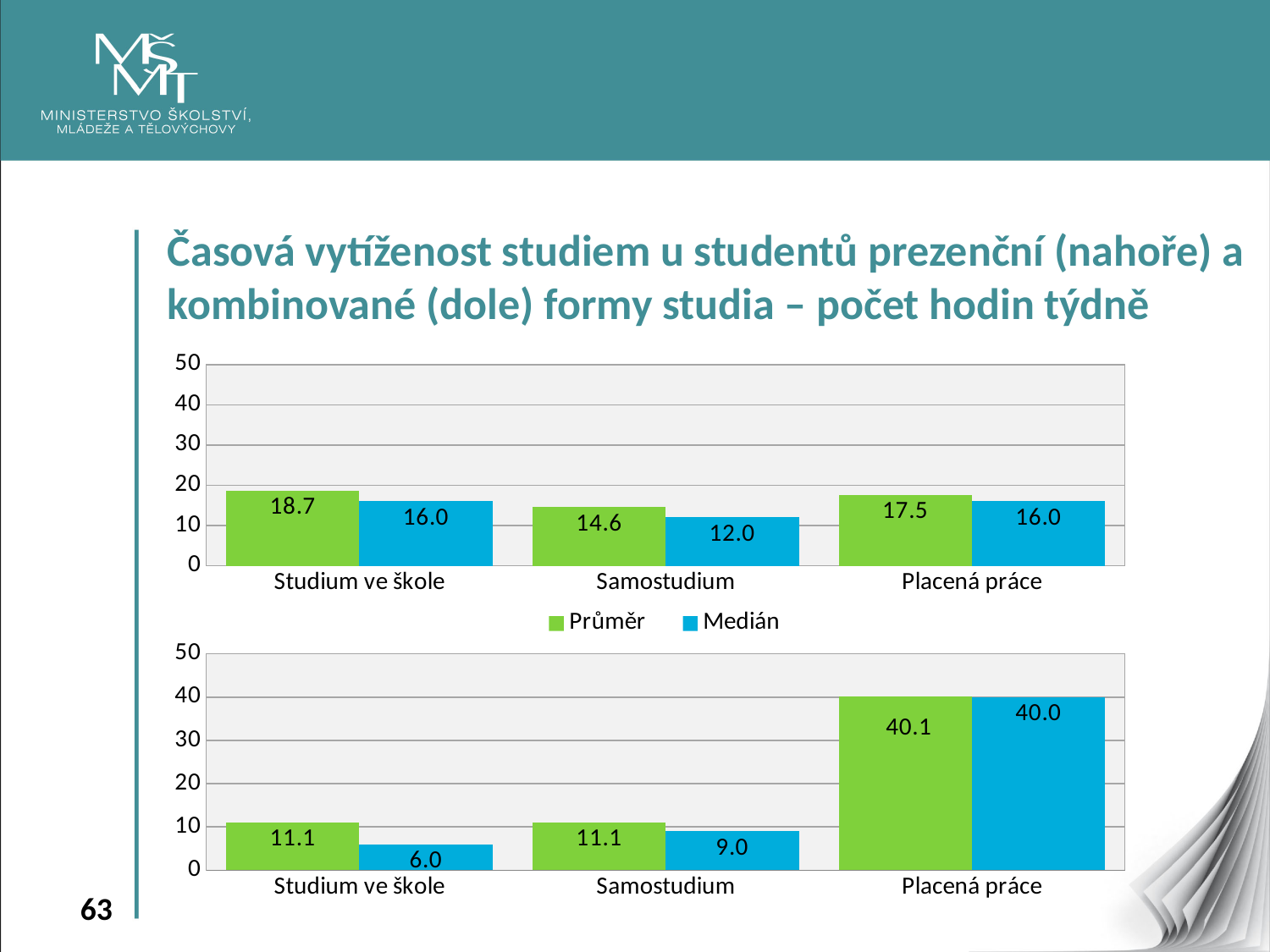
In the bottom chart, which is larger for Samostudium: Průměr or Medián? Průměr In the bottom chart, is the Medián value for Placená práce greater or less than 30? greater In the bottom chart, what is the Průměr value for Placená práce? 40.1 How many categories are shown on the x axis of the top chart? 3 In the top chart, which category has the lowest Medián value? Samostudium In the bottom chart, which category has the highest Průměr value? Placená práce In the top chart, what is the Průměr value for Studium ve škole? 18.7 In the top chart, what is the Medián value for Samostudium? 12.0 How many series does the legend list? 2 What type of chart is the bottom chart? bar chart In the top chart, what is the difference between the Průměr and Medián values for Studium ve škole? 2.7 In the bottom chart, what is the Medián value for Studium ve škole? 6.0